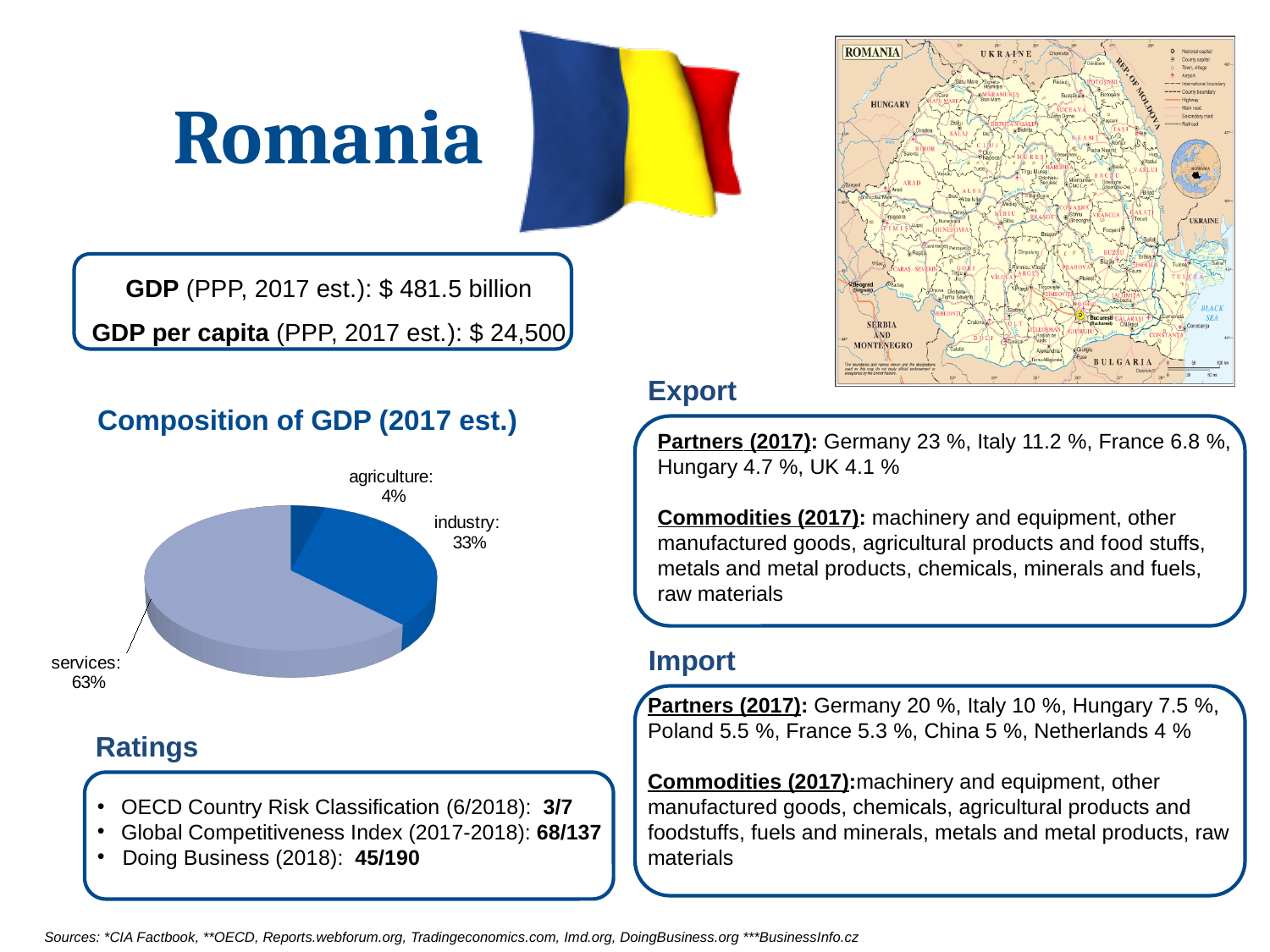
What share of GDP does industry account for in the Composition of GDP (2017 est.) chart? 33% Which is larger in the Composition of GDP chart, the share of industry or the share of agriculture? industry Which sector has the smallest share in the Composition of GDP (2017 est.) chart? agriculture What is the title of the pie chart on the slide? Composition of GDP (2017 est.) Which sector has the largest share in the Composition of GDP (2017 est.) chart? services What share of GDP does agriculture account for in the Composition of GDP (2017 est.) chart? 4% What type of chart is used to show the Composition of GDP (2017 est.)? pie chart What is the combined share of industry and agriculture in the Composition of GDP chart? 37% What is the difference in percentage points between the services and industry shares in the Composition of GDP chart? 30 What is the difference in percentage points between the industry and agriculture shares in the Composition of GDP chart? 29 How many sectors are shown in the Composition of GDP (2017 est.) pie chart? 3 What share of GDP does services account for in the Composition of GDP (2017 est.) chart? 63%